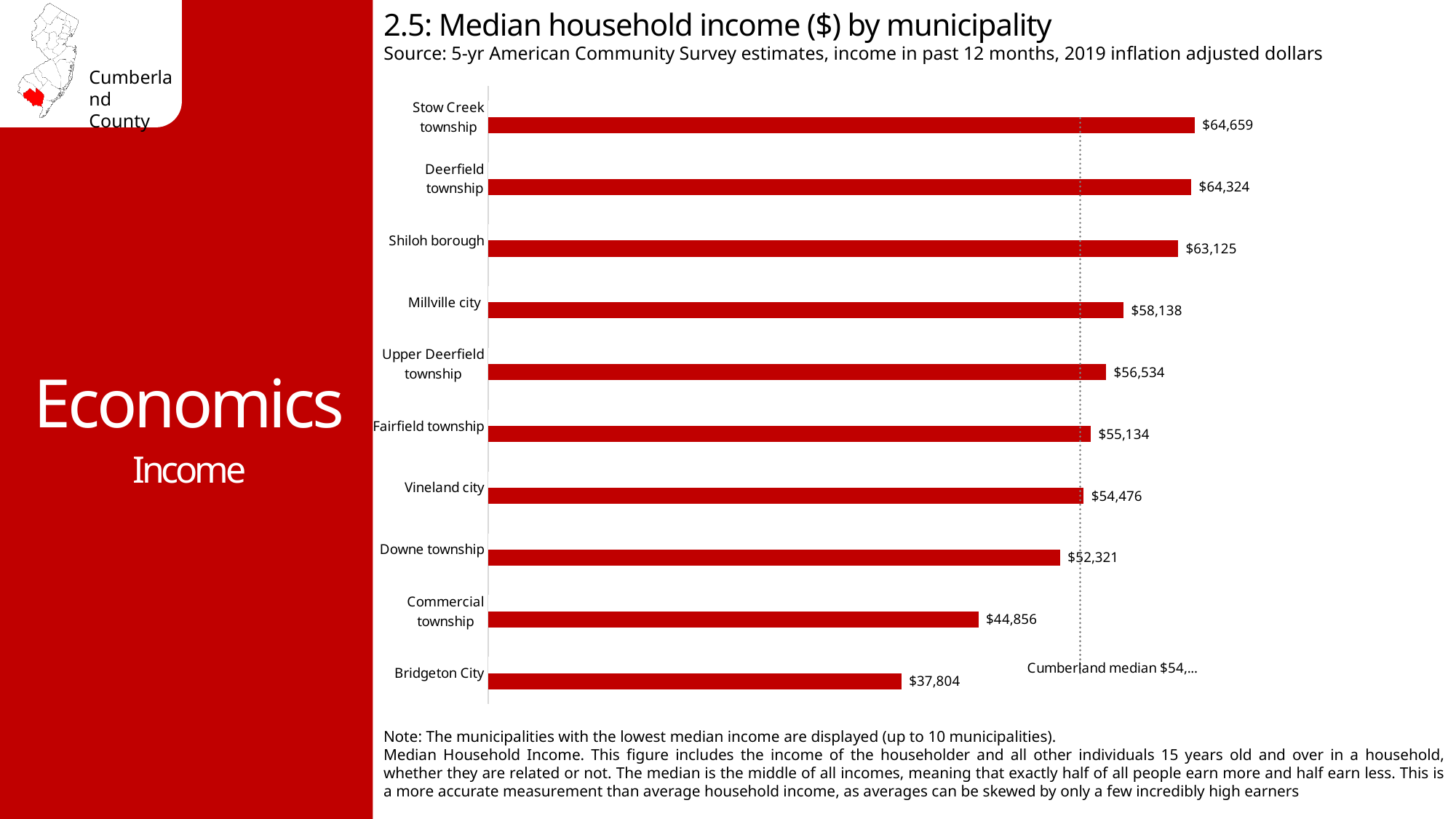
What is the title of the chart? 2.5: Median household income ($) by municipality What is the median household income for Bridgeton City? $37,804 What is the median household income for Millville city? $58,138 What is the difference in median household income between Shiloh borough and Millville city? $4,987 Which has a higher median household income, Upper Deerfield township or Fairfield township? Upper Deerfield township What is the median household income for Commercial township? $44,856 Which municipality has the highest median household income on the chart? Stow Creek township Which has a higher median household income, Vineland city or Downe township? Vineland city How many municipalities are shown on the chart? 10 What is the difference in median household income between Stow Creek township and Bridgeton City? $26,855 Which municipality has the lowest median household income on the chart? Bridgeton City What kind of chart is used to show median household income by municipality? Bar chart